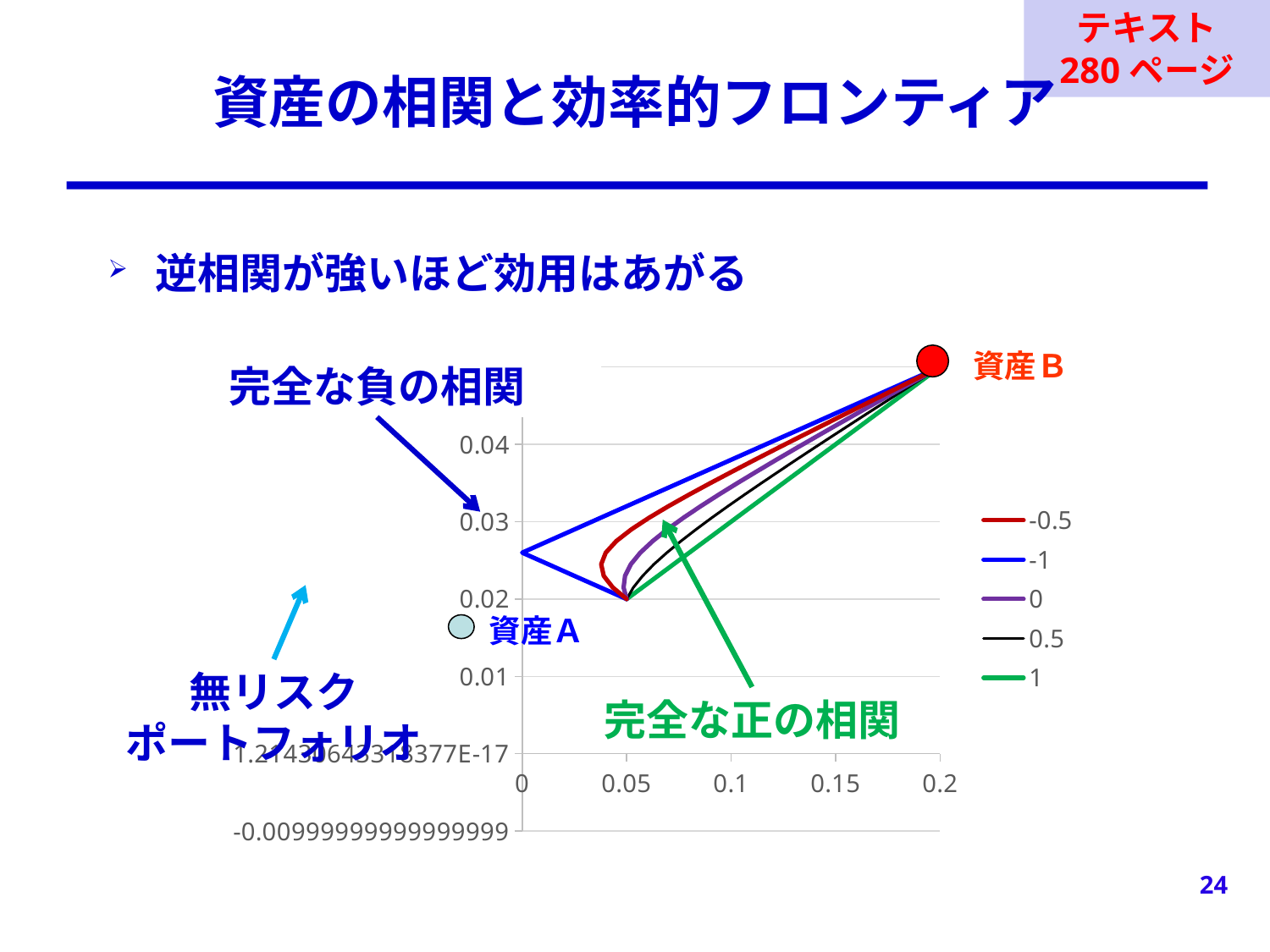
Is the x value of the leftmost point of the -1 series greater or less than 0.05? less Which series reaches a smaller x-axis value, -1 or 1? -1 Does the series labelled 1 rise or fall as the x value increases? rise How many tick labels are shown on the x axis? 5 At what x-axis value do all the series meet at their right-hand end (資産B)? 0.2 Is the y value of the point labelled 資産B greater or less than 0.04? greater What kind of chart is shown on the slide? line chart What colour is the line for the series labelled -1? blue How many series does the legend list? 5 At what x-axis value do the -0.5, 0, 0.5 and 1 series start at their lower-left end? 0.05 Which series reaches the smallest value on the x axis? -1 What are the legend entries of the chart, from top to bottom? -0.5, -1, 0, 0.5, 1